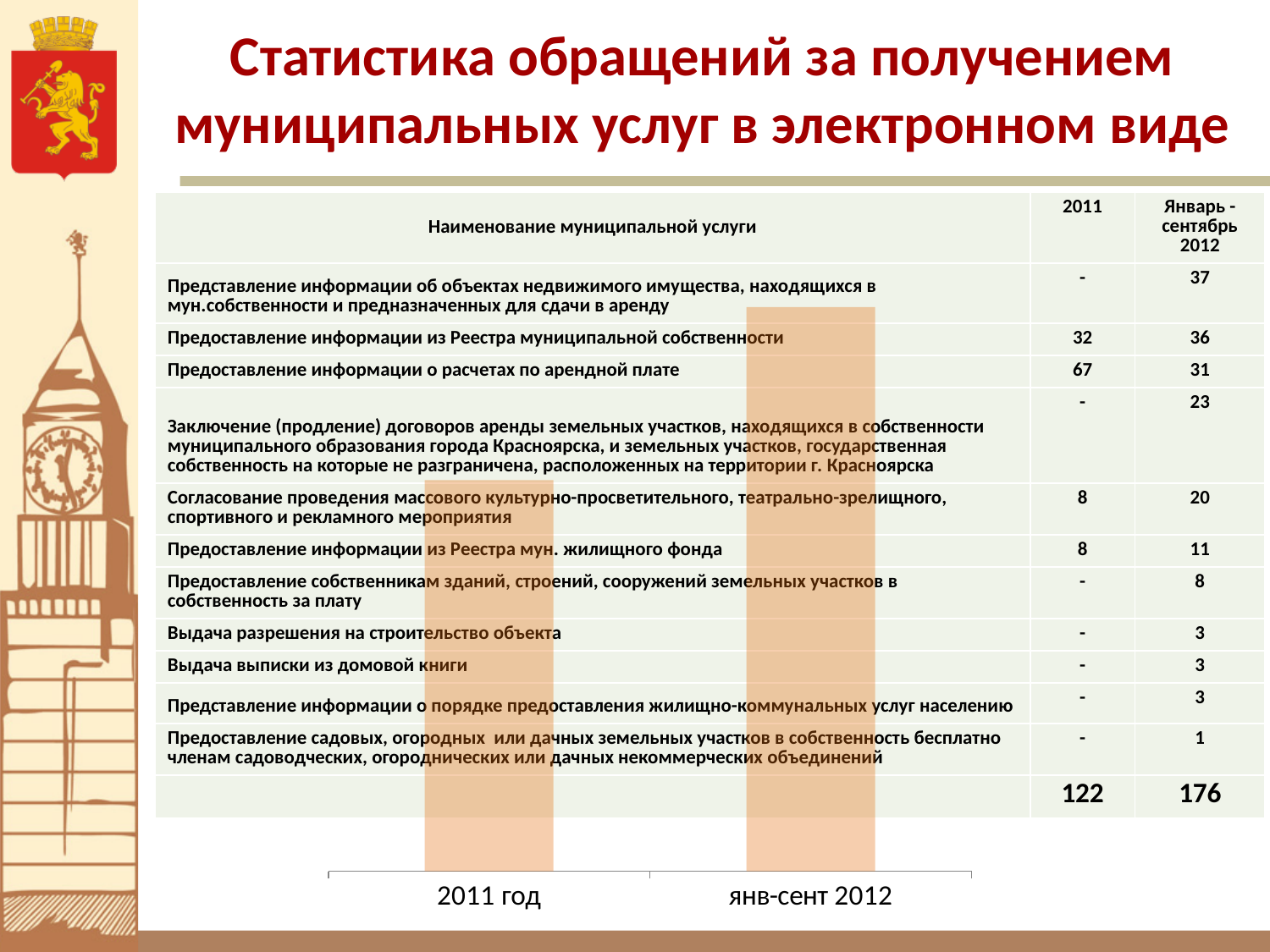
What kind of chart is shown on the slide behind the table? bar chart Do the bar values rise or fall from left to right along the x axis of the chart? rise What is the label of the left bar in the chart? 2011 год What is the label of the right bar in the chart? янв-сент 2012 How many bars does the chart on the slide have? 2 Which bar in the chart is the shortest? 2011 год Which bar is taller in the chart: 2011 год or янв-сент 2012? янв-сент 2012 Which bar in the chart is the tallest? янв-сент 2012